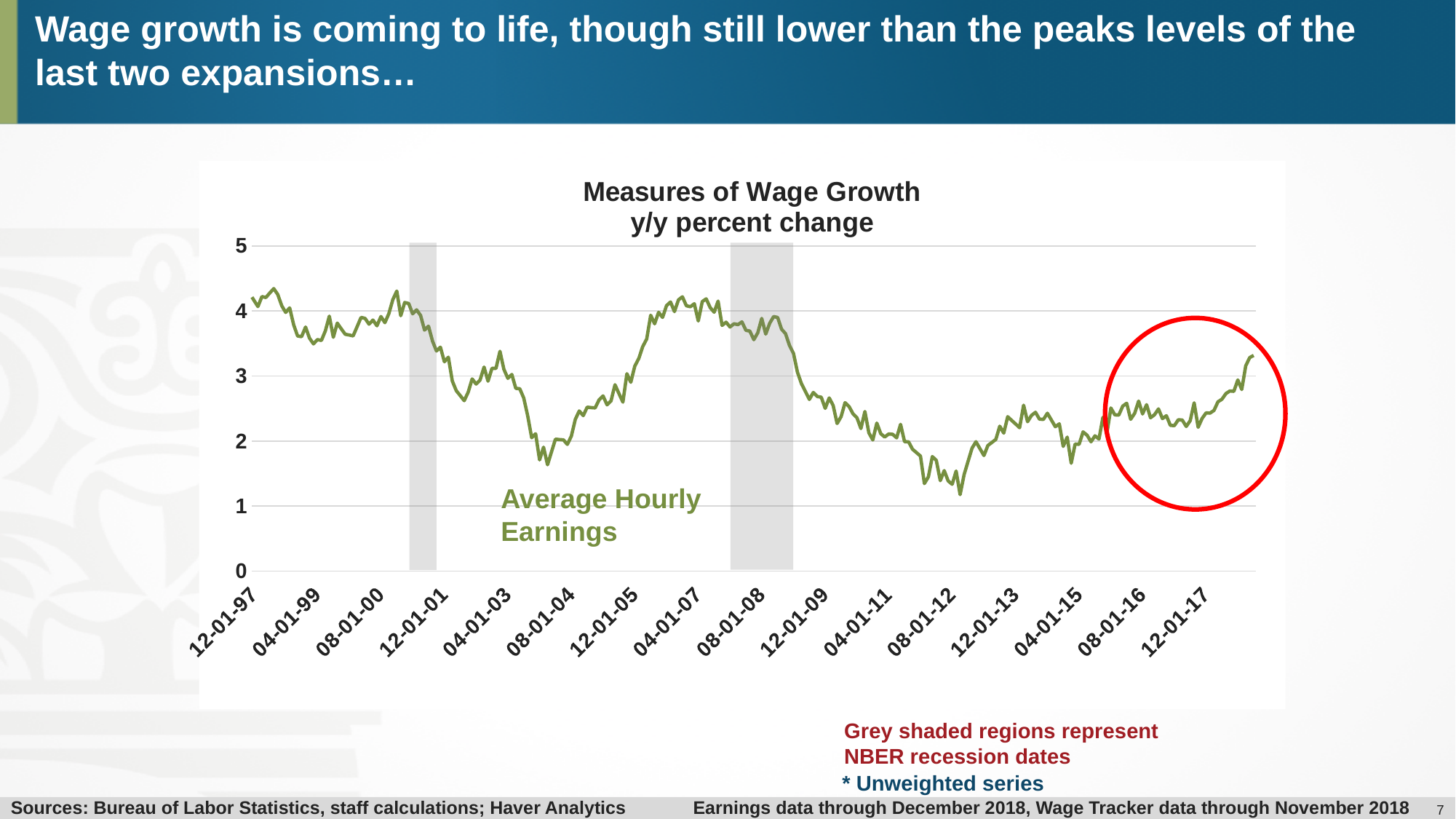
Is the value for Average Hourly Earnings at 12-01-17 greater or less than 3? less What is the name of the series plotted on the chart? Average Hourly Earnings Is the value for Average Hourly Earnings at 04-01-99 greater or less than 4? less Does the Average Hourly Earnings line rise or fall between 04-01-07 and 08-01-12? fall Is the value for Average Hourly Earnings at 12-01-13 greater or less than 3? less What kind of chart is shown on the slide? Line chart What is the title of the chart? Measures of Wage Growth y/y percent change Near which x-axis label does the Average Hourly Earnings line reach its lowest value? 08-01-12 How many date labels are shown on the x axis? 16 Does the Average Hourly Earnings line rise or fall between 08-01-16 and the end of the series? rise